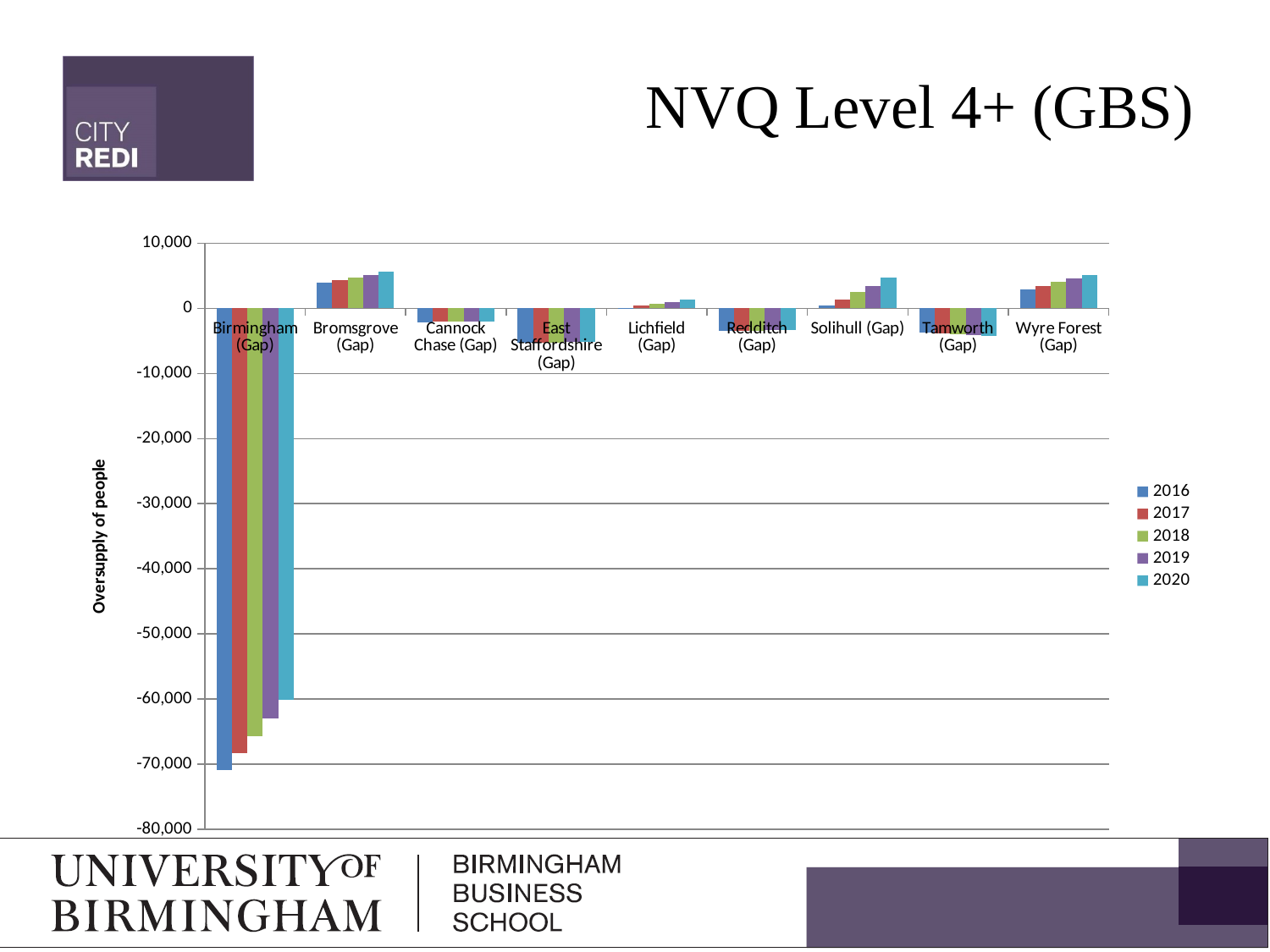
How many series does the legend list? 5 Which category has the lowest (most negative) values? Birmingham (Gap) Is the 2016 value for Birmingham (Gap) greater or less than -60,000? less Is the 2020 value for Bromsgrove (Gap) greater or less than 10,000? less Do the values for Solihull (Gap) rise or fall from 2016 to 2020? rise Which is larger, the 2016 value for Birmingham (Gap) or the 2016 value for Bromsgrove (Gap)? Bromsgrove (Gap) What is the title of the chart? NVQ Level 4+ (GBS) How many categories are shown along the x axis? 9 What is the label on the vertical axis? Oversupply of people Do the values for Birmingham (Gap) rise or fall from 2016 to 2020? rise What kind of chart is shown on the slide? bar chart Is the 2020 value for Birmingham (Gap) greater or less than -70,000? greater